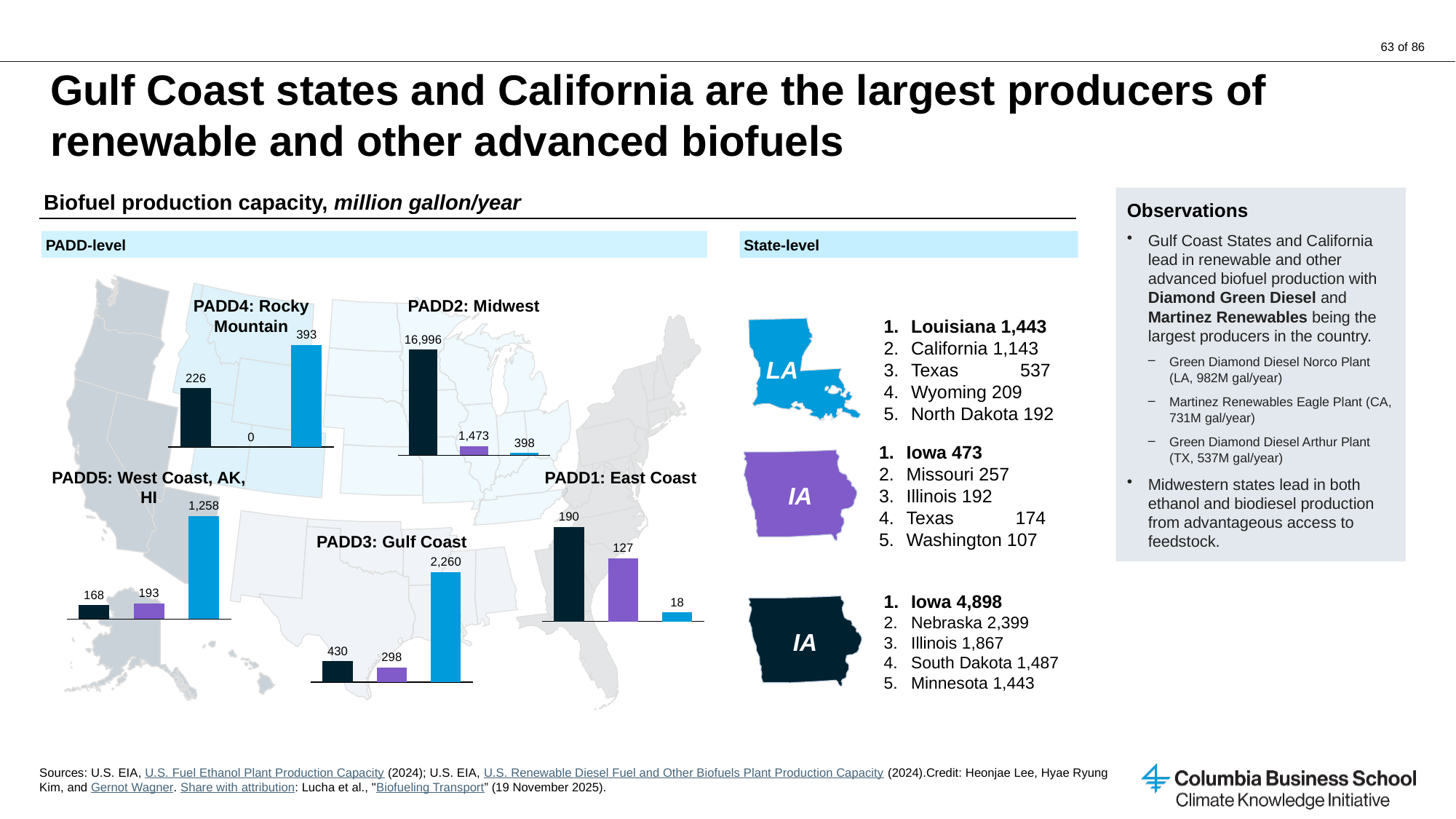
In the PADD4: Rocky Mountain chart, what is the value of the middle (purple) bar? 0 What kind of chart is used for each PADD region on the map? Bar chart What unit is stated in the heading above the PADD-level and State-level charts? million gallon/year In the PADD3: Gulf Coast chart, what is the difference between the dark navy bar (430) and the purple bar (298)? 132 In the PADD3: Gulf Coast chart, what is the value of the tallest (light blue) bar? 2,260 In the PADD5: West Coast, AK, HI chart, which is larger: the dark navy bar or the purple bar? The purple bar (193) In the PADD2: Midwest chart, what is the value of the first (dark navy) bar? 16,996 In the PADD4: Rocky Mountain chart, what is the difference between the light blue bar (393) and the dark navy bar (226)? 167 In the PADD1: East Coast chart, what is the value of the lowest bar? 18 What is the total of the three bars in the PADD1: East Coast chart (190, 127 and 18)? 335 How many bars are shown in the PADD3: Gulf Coast chart? 3 Across all five PADD-level charts, which PADD has the single tallest bar? PADD2: Midwest